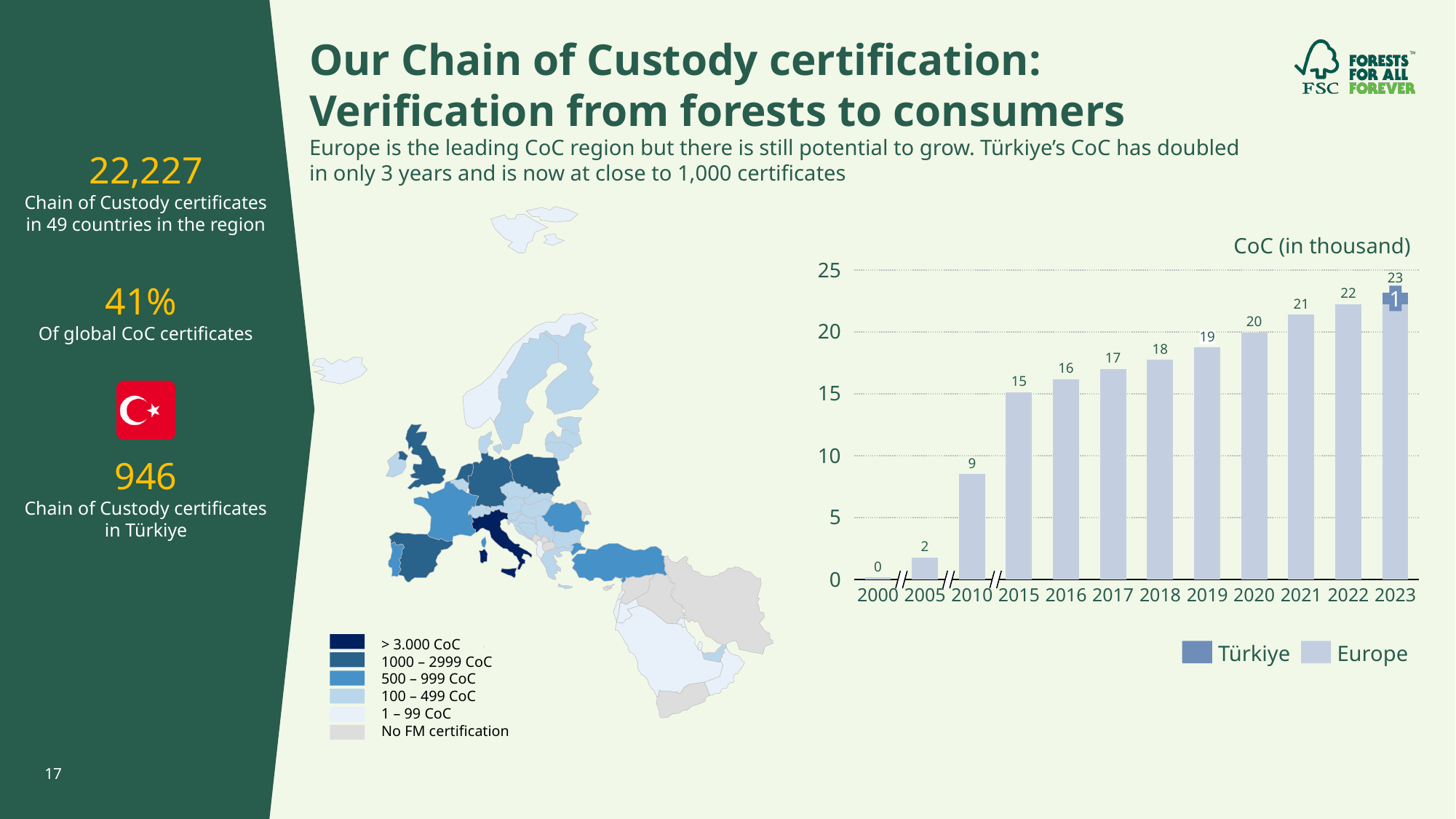
What kind of chart is the CoC (in thousand) chart? Bar chart In the CoC (in thousand) bar chart, what is the value shown for 2010? 9 In the CoC (in thousand) bar chart, what value is labelled on the Türkiye segment of the 2023 bar? 1 In the CoC (in thousand) bar chart, what is the difference between the values for 2020 and 2010? 11 In the CoC (in thousand) bar chart, which year has the highest value? 2023 In the CoC (in thousand) bar chart, which is larger, the value for 2017 or the value for 2019? 2019 In the CoC (in thousand) bar chart, how many years are shown on the x axis? 12 In the CoC (in thousand) bar chart, what is the value shown for 2015? 15 How many series does the legend of the CoC (in thousand) bar chart list? 2 In the CoC (in thousand) bar chart, do the values rise or fall from 2000 to 2023? Rise In the CoC (in thousand) bar chart, what is the value shown for 2005? 2 In the CoC (in thousand) bar chart, which year has the lowest value? 2000